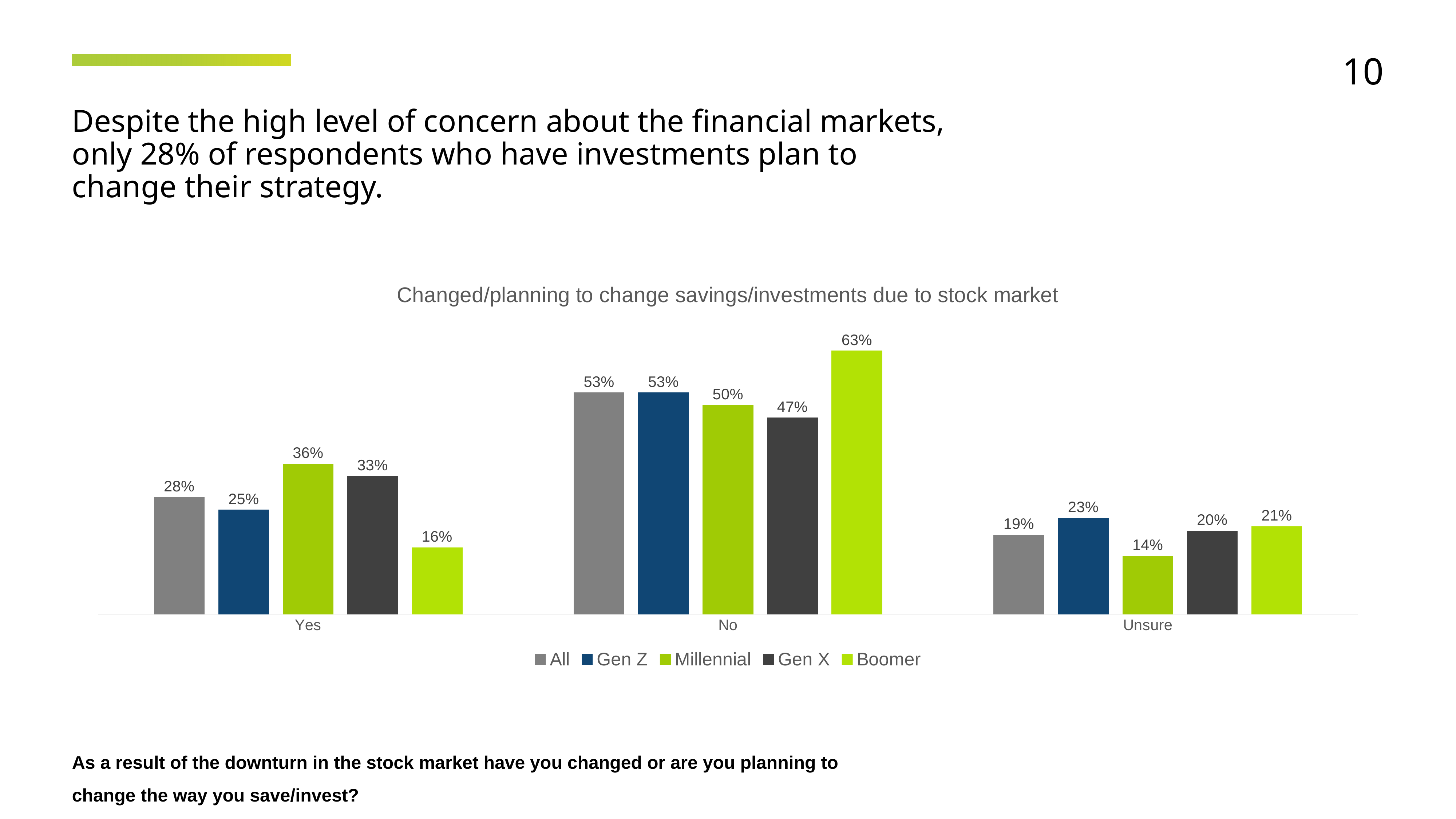
How many categories are shown on the x axis? 3 What is the value for All in the Unsure category? 19% What is the title of the chart? Changed/planning to change savings/investments due to stock market Which series has the highest value in the No category? Boomer Which series has the lowest value in the Yes category? Boomer What is the value for Millennial in the Yes category? 36% Which series has the lowest value in the Unsure category? Millennial What is the difference between the Millennial and Boomer values in the Yes category? 20% What kind of chart is shown? Bar chart How many series does the legend list? 5 Which is larger in the Unsure category, Gen Z or Gen X? Gen Z What is the value for Boomer in the No category? 63%